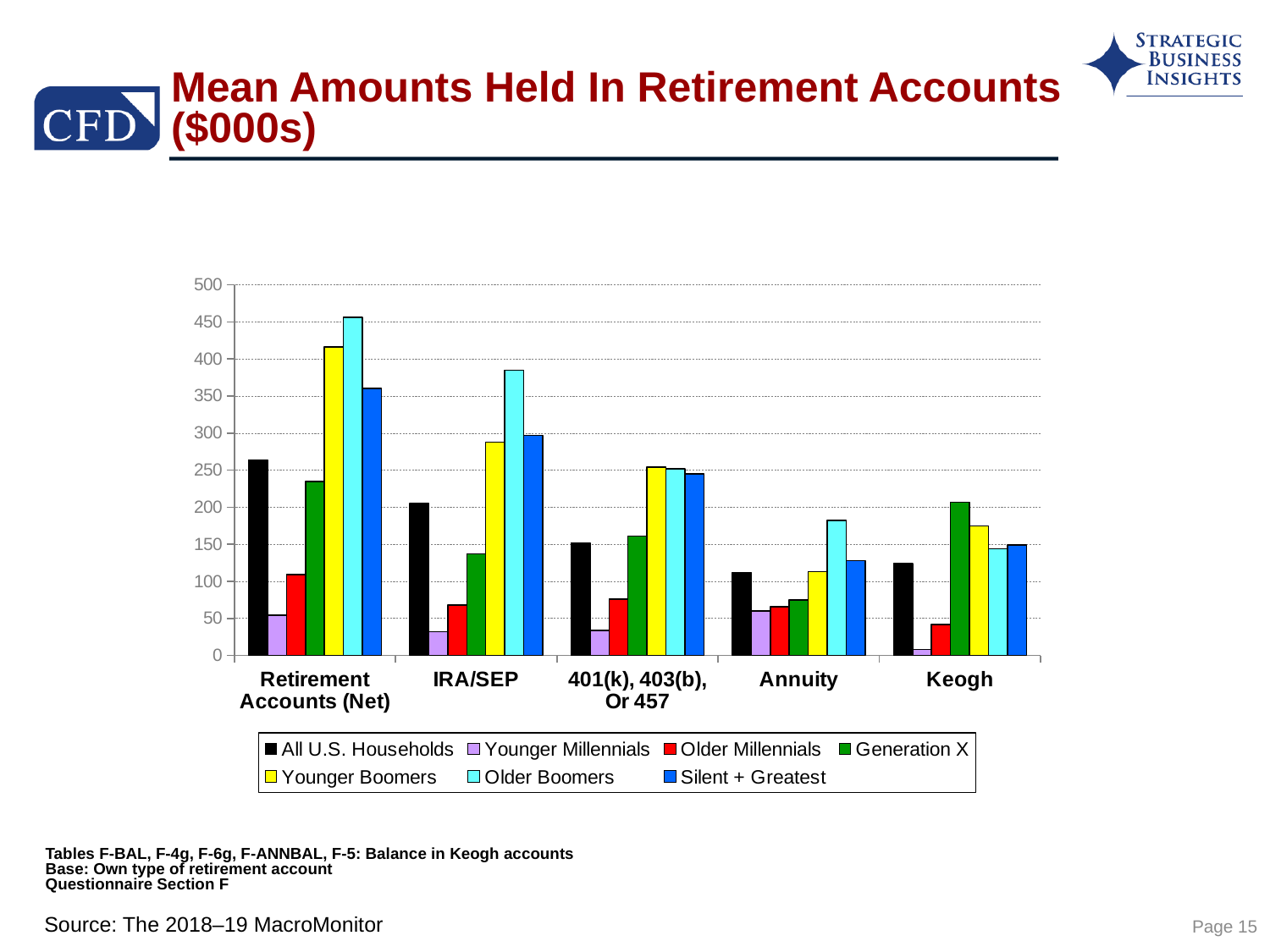
Is the value for Older Boomers in Retirement Accounts (Net) greater or less than 400? greater For IRA/SEP, which is larger: Older Boomers or Silent + Greatest? Older Boomers What kind of chart is shown on the slide? bar chart Is the value for Younger Millennials in IRA/SEP greater or less than 50? less Which series has the highest value for Annuity? Older Boomers Which series has the highest value for Retirement Accounts (Net)? Older Boomers How many series does the legend list? 7 Is the value for Older Boomers in Annuity greater or less than 150? greater Which series has the lowest value for Keogh? Younger Millennials What is the title of the chart? Mean Amounts Held In Retirement Accounts ($000s) Which series has the highest value for Keogh? Generation X How many account categories are shown on the x axis? 5